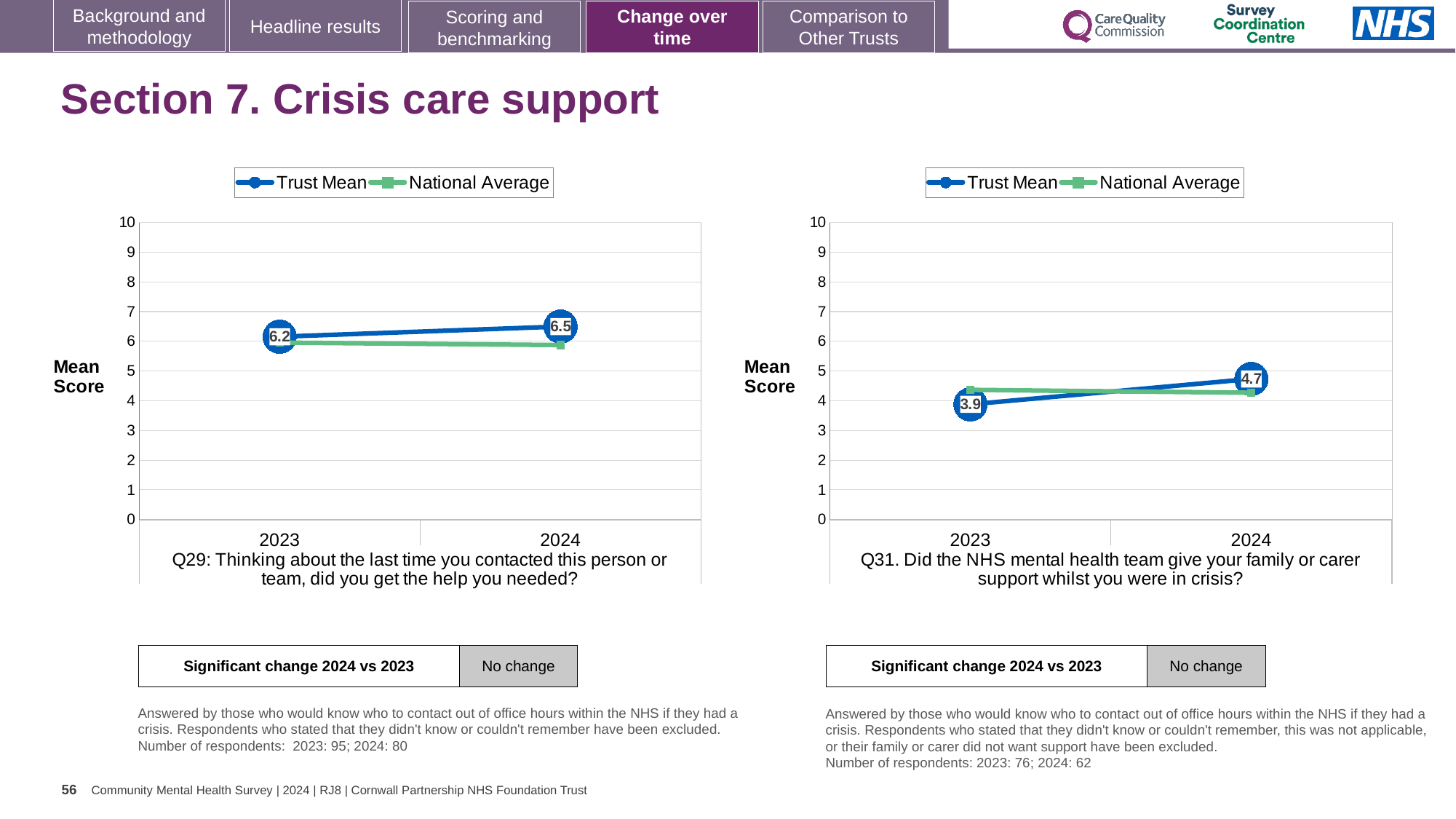
In the Q29 chart on the left, by how much did the Trust Mean change from 2023 to 2024? 0.3 What kind of chart is the Q29 chart on the left? line chart In the Q31 chart on the right, what is the difference between the Trust Mean in 2024 and in 2023? 0.8 In the Q29 chart on the left, what is the Trust Mean for 2023? 6.2 In the Q29 chart on the left, what is the Trust Mean for 2024? 6.5 In the Q31 chart on the right, which is higher in 2024, the Trust Mean or the National Average? Trust Mean In the Q31 chart on the right, what is the Trust Mean for 2024? 4.7 How many series does the legend of the Q29 chart on the left list? 2 In the Q31 chart on the right, does the Trust Mean rise or fall from 2023 to 2024? rise In the Q31 chart on the right, which is higher in 2023, the Trust Mean or the National Average? National Average In the Q31 chart on the right, is the National Average for 2023 greater or less than 4? greater In the Q31 chart on the right, what is the Trust Mean for 2023? 3.9